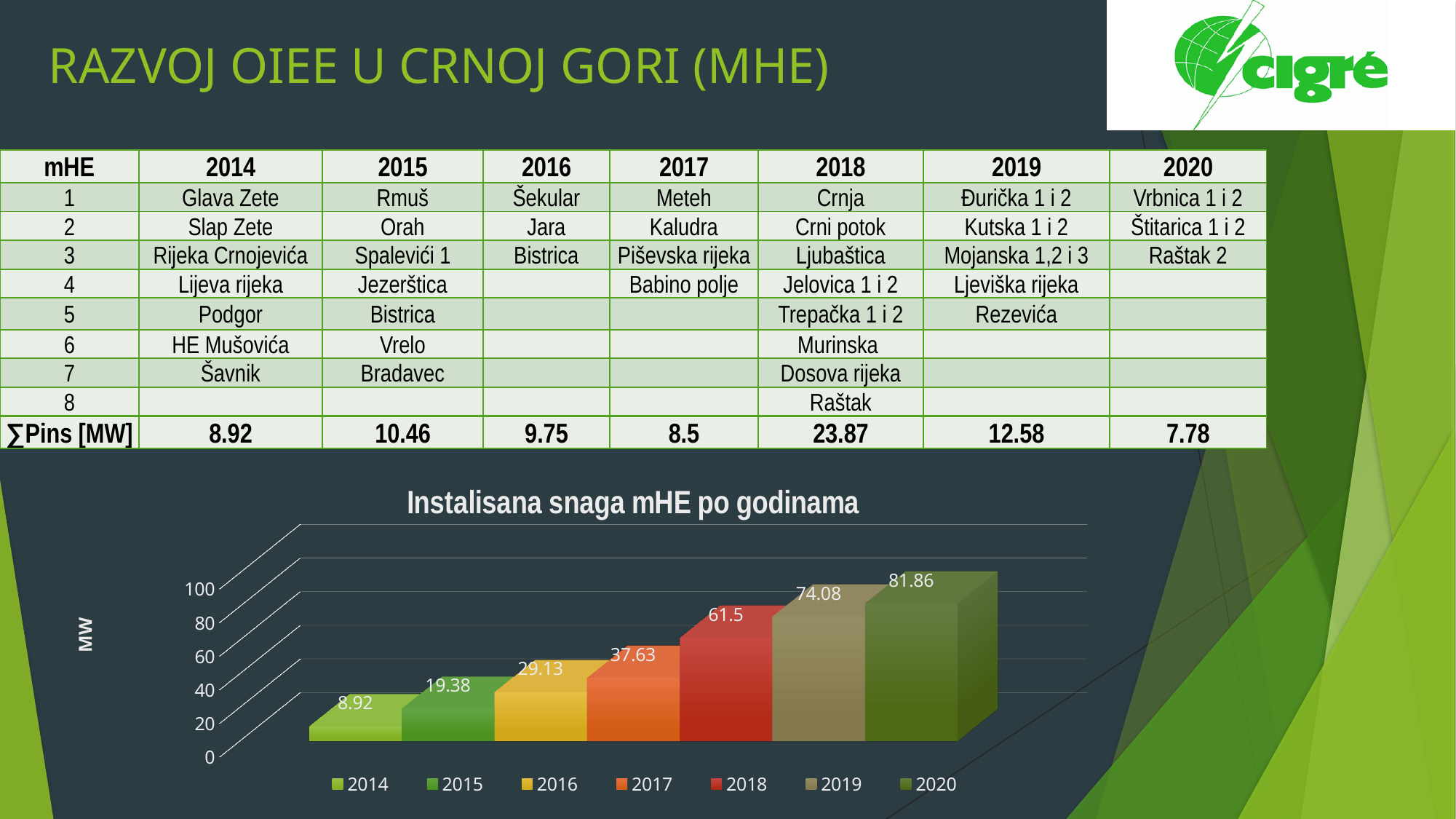
How many entries does the chart legend list? 7 Do the values in the chart rise or fall from 2014 to 2020? rise What is the value shown for 2018 in the chart? 61.5 What is the difference between the values for 2019 and 2018 in the chart? 12.58 What is the value shown for 2020 in the chart? 81.86 What is the title of the chart on the slide? Instalisana snaga mHE po godinama What type of chart is shown on the slide? bar chart Which year has the lowest value in the chart? 2014 Which year has the highest value in the chart? 2020 What is the value shown for 2014 in the chart? 8.92 Is the value for 2019 in the chart greater or less than 60? greater Which is larger in the chart, the value for 2016 or the value for 2017? 2017